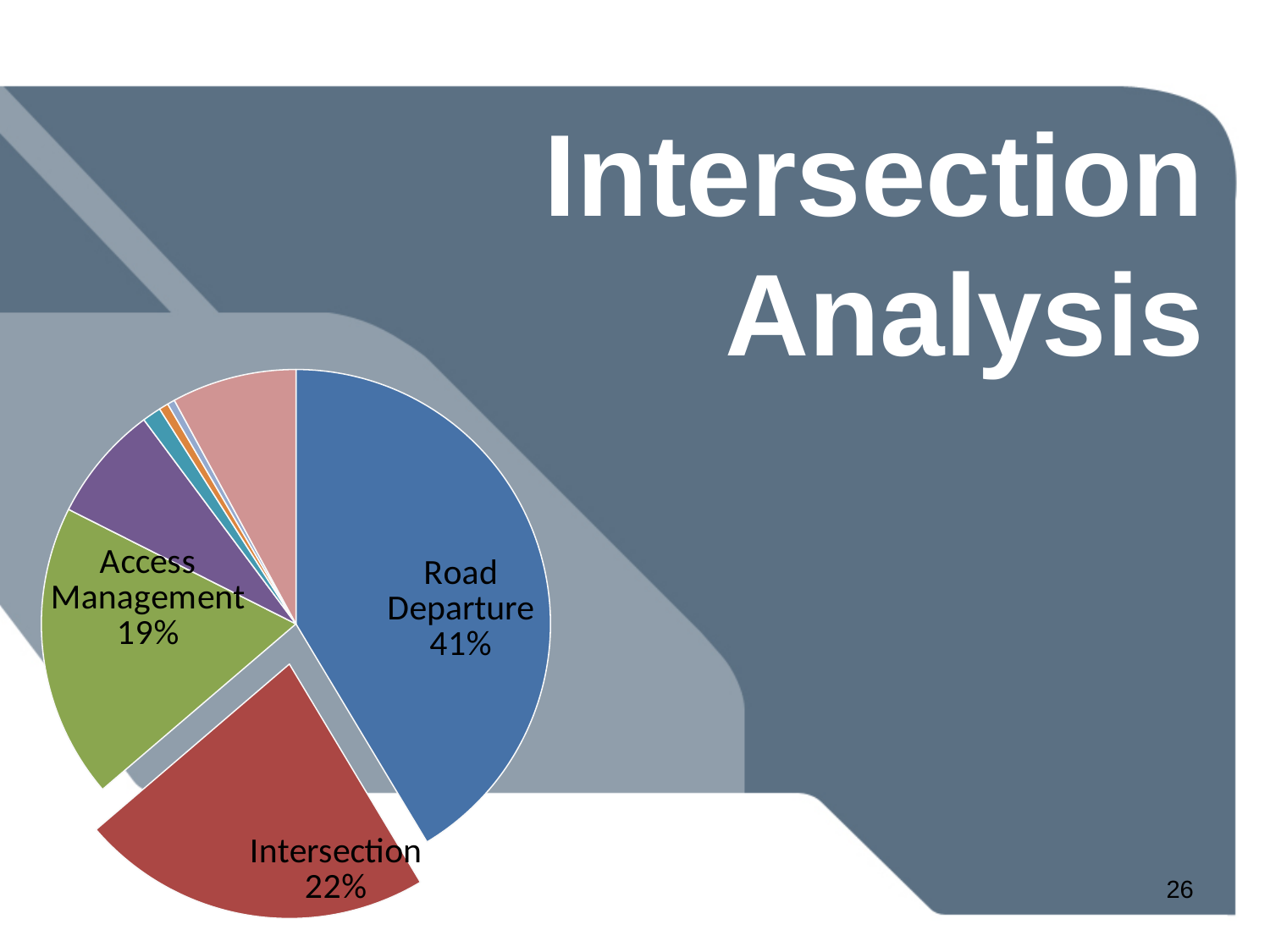
Of the three labelled slices, which is the smallest? Access Management Which slice of the pie chart is the largest? Road Departure What percentage of the pie is Access Management? 19% What kind of chart is shown on the slide? pie chart What colour is the Road Departure slice? blue How many percentage points larger is Road Departure than Intersection? 19% What percentage of the pie is Intersection? 22% Which is larger, the Intersection slice or the Access Management slice? Intersection Which slice is pulled out (exploded) from the rest of the pie? Intersection What share of the pie does Road Departure represent? 41% What is the difference between the Intersection and Access Management percentages? 3% What percentage of the pie is Road Departure? 41%